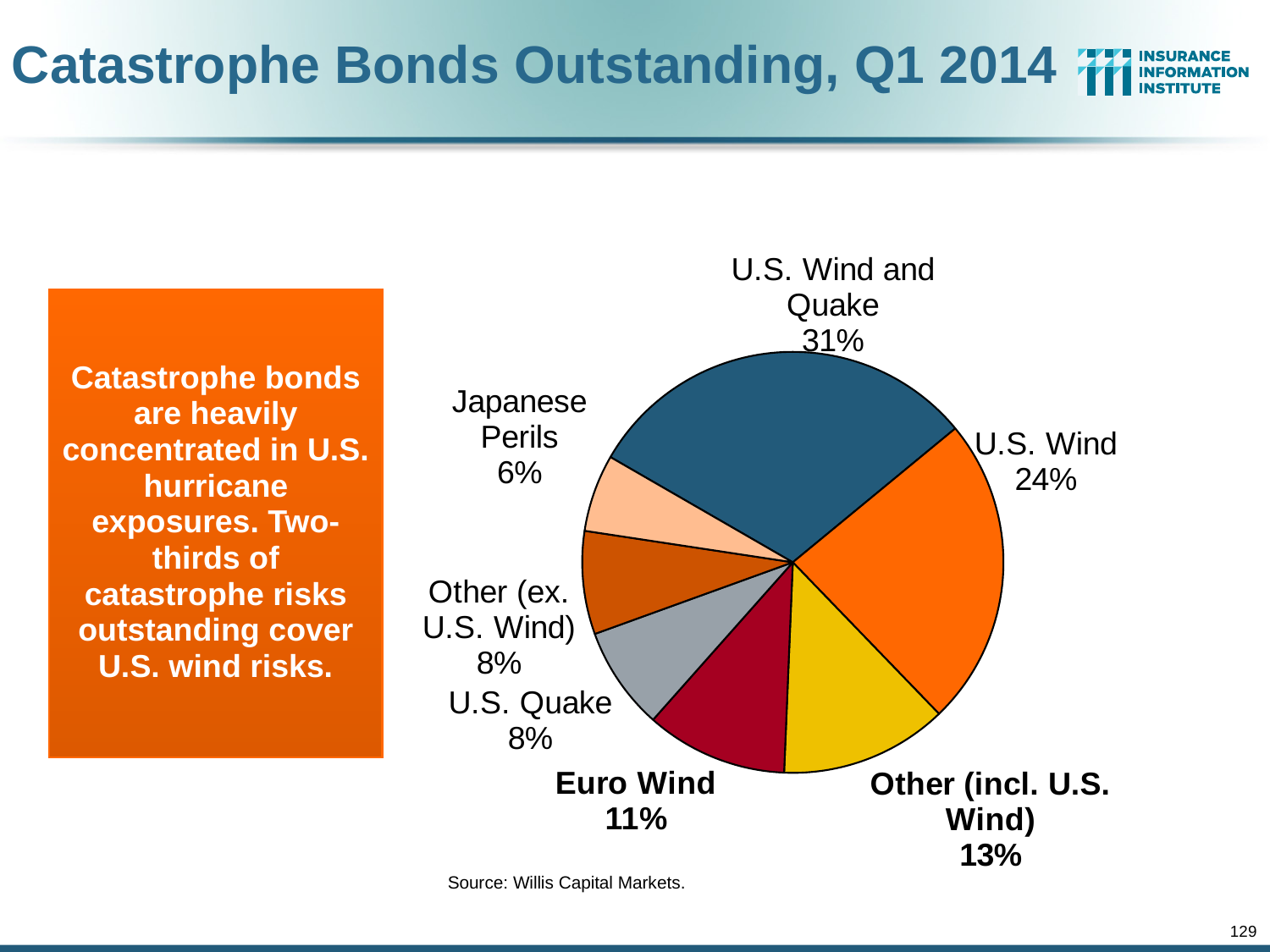
What is the source cited for the chart? Willis Capital Markets What kind of chart is shown on the slide? Pie chart What share does Japanese Perils hold? 6% What is the value for Other (incl. U.S. Wind)? 13% Which category has the largest share of the pie? U.S. Wind and Quake Which category has the smallest share of the pie? Japanese Perils How many slices does the pie chart have? 7 What percentage of the pie is Euro Wind? 11% What is the combined share of U.S. Wind and Quake and U.S. Wind? 55% Which is larger, Euro Wind or U.S. Quake? Euro Wind What is the difference in percentage points between U.S. Wind and Quake and U.S. Wind? 7 What share of catastrophe bonds outstanding is for U.S. Wind and Quake? 31%